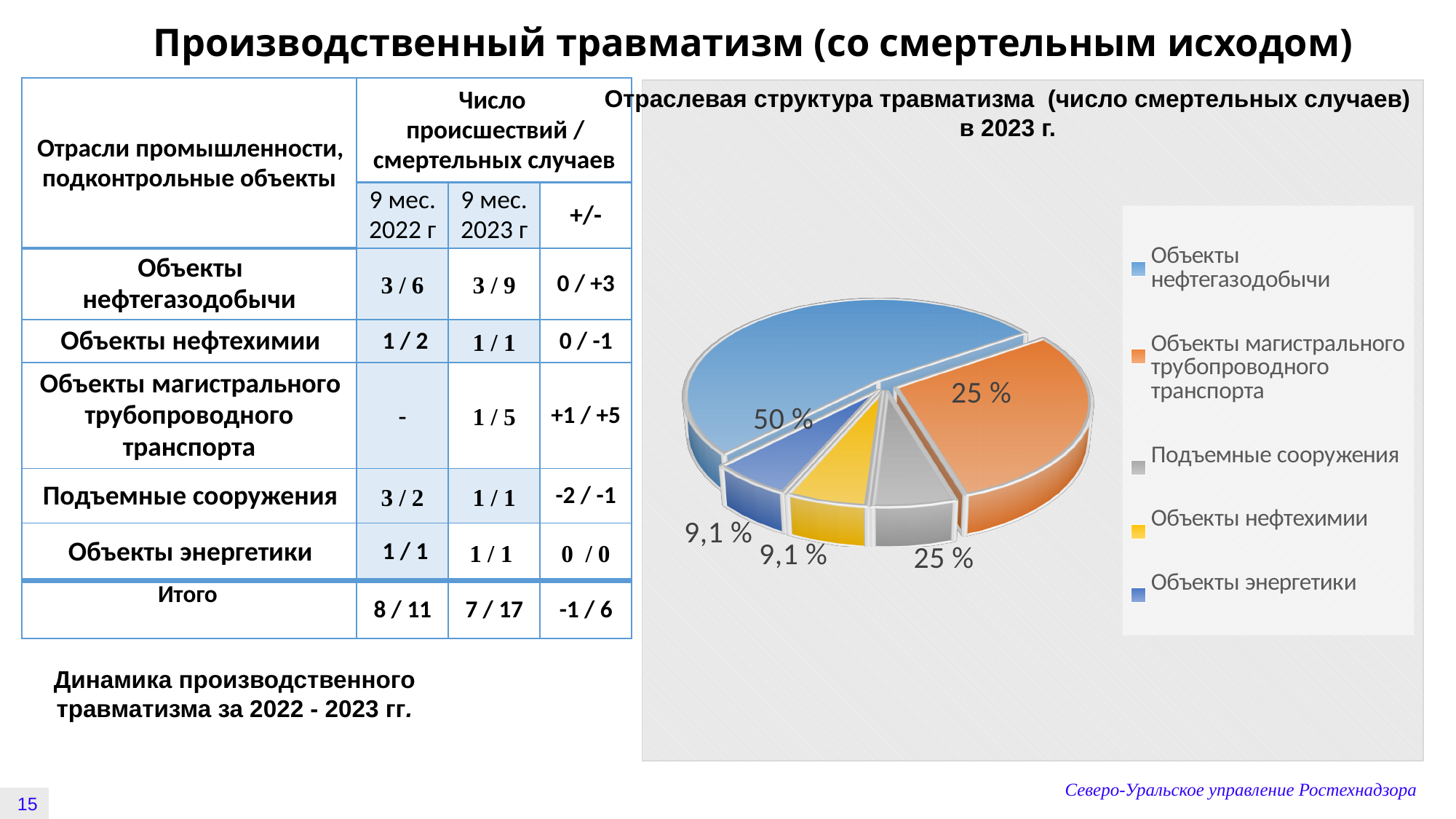
What colour is the slice for "Объекты нефтегазодобычи"? blue What share of the pie does "Объекты нефтехимии" have? 9,1 % What share of the pie does "Объекты нефтегазодобычи" have? 50 % Which category has the largest slice of the pie? Объекты нефтегазодобычи How many entries does the legend of the pie chart list? 5 What share of the pie does "Объекты энергетики" have? 9,1 % What share of the pie does "Объекты магистрального трубопроводного транспорта" have? 25 % Which is larger: the slice for "Объекты нефтегазодобычи" or the slice for "Объекты магистрального трубопроводного транспорта"? Объекты нефтегазодобычи How many slices does the pie chart have? 5 What kind of chart is shown on the slide? pie chart By how many percentage points does the share of "Объекты нефтегазодобычи" exceed the share of "Объекты магистрального трубопроводного транспорта"? 25 % What is the title of the pie chart? Отраслевая структура травматизма (число смертельных случаев) в 2023 г.